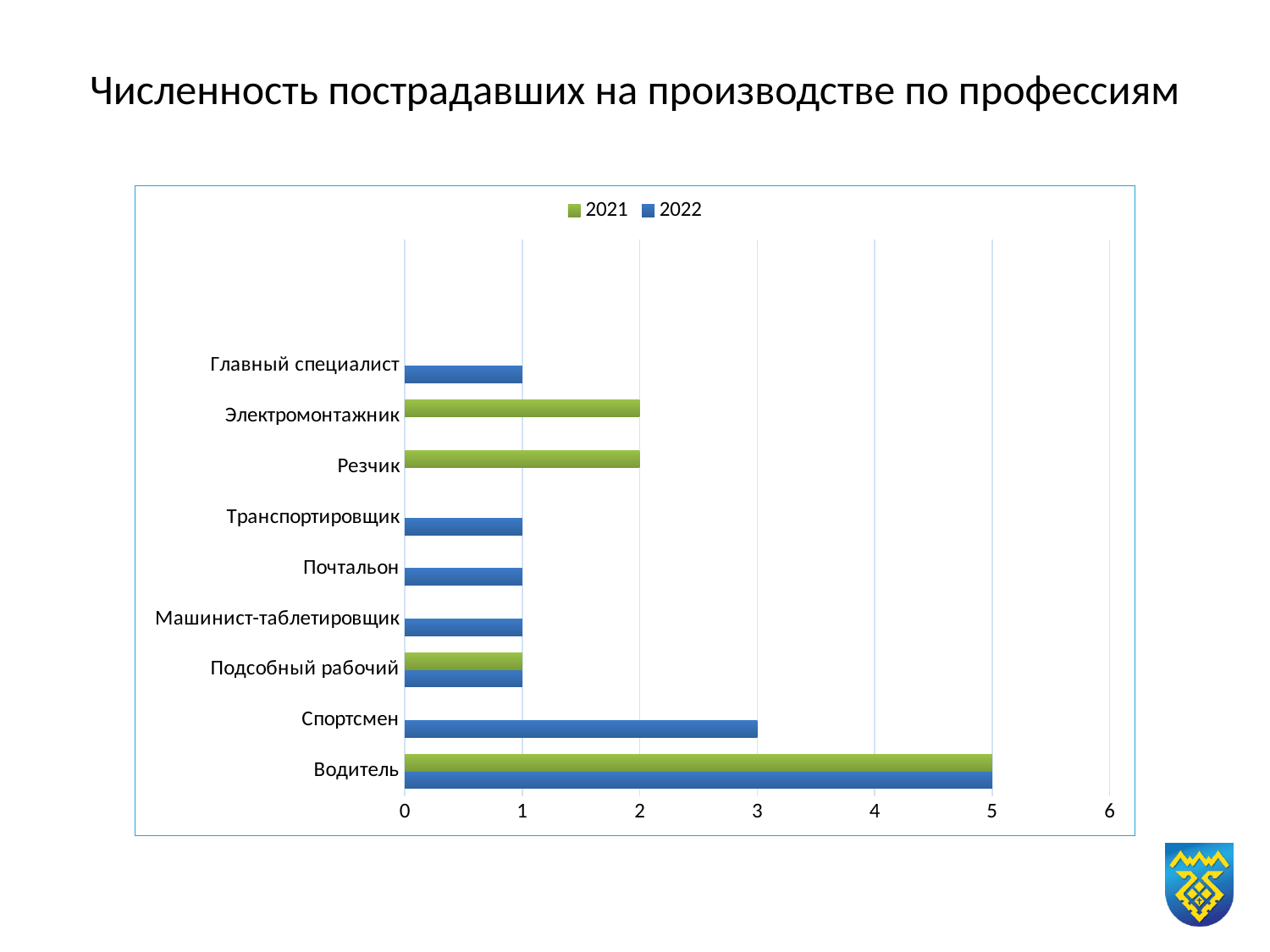
What kind of chart is shown on the slide? bar chart Which series is shown in green in the legend? 2021 What is the value for Электромонтажник in 2021? 2 What is the value for Подсобный рабочий in 2021? 1 How many professions (categories) are shown on the chart? 9 Which profession has the highest value in 2022? Водитель Which is larger: the 2021 value for Резчик or the 2022 value for Почтальон? the 2021 value for Резчик What is the value for Спортсмен in 2022? 3 How many series does the legend list? 2 What is the value for Водитель in 2022? 5 What is the difference between the 2022 values for Водитель and Спортсмен? 2 Which profession has the highest value in 2021? Водитель